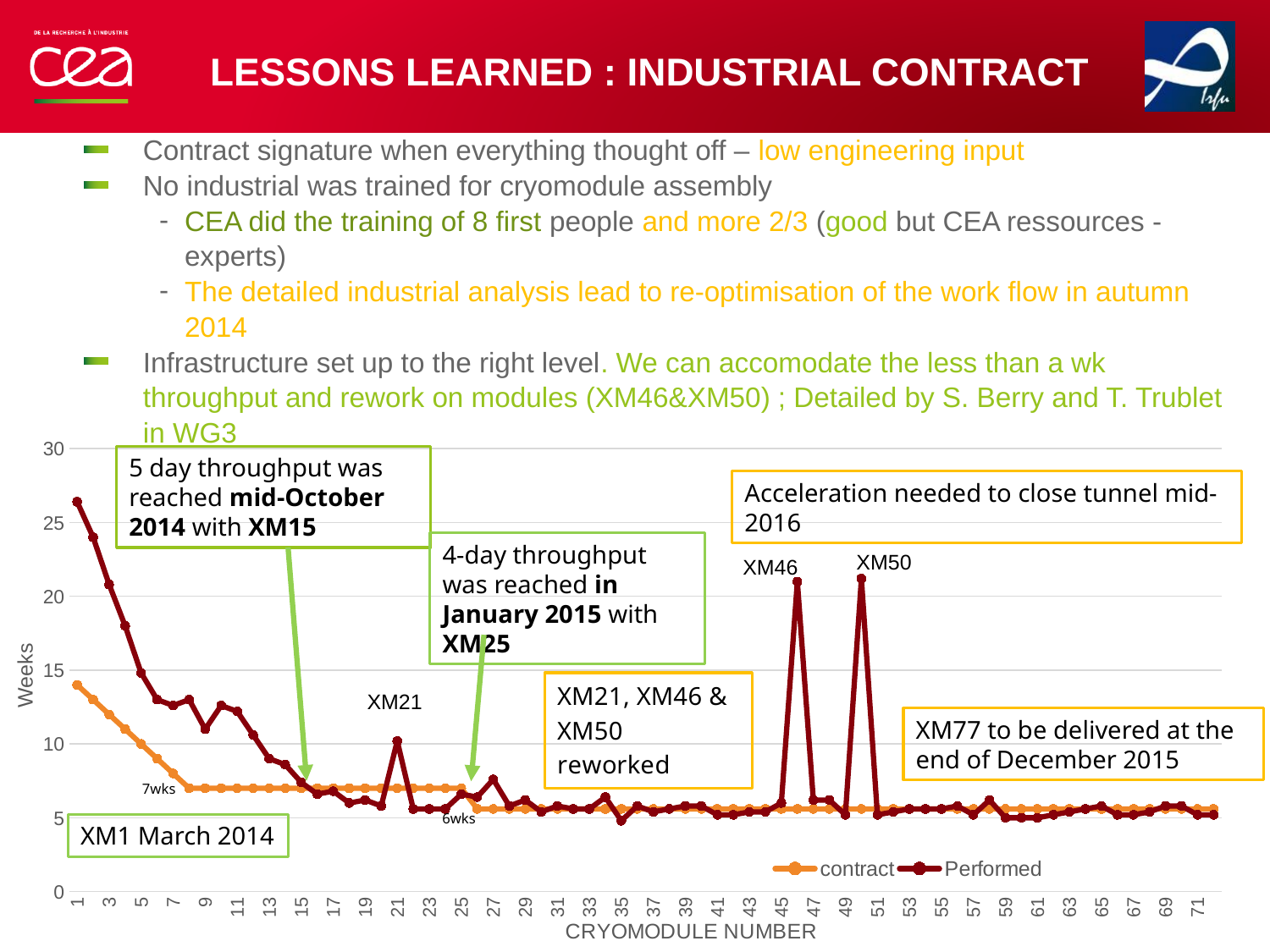
How many series does the chart legend list? 2 Is the contract value at cryomodule number 1 greater or less than 10 weeks? greater What are the two series named in the chart legend? contract and Performed What kind of chart is shown on the slide? line chart Is the Performed value at XM46 greater or less than 20 weeks? greater What value is printed as a data label on the contract line near cryomodule number 25? 6wks What value is printed as a data label on the contract line near cryomodule number 7? 7wks At cryomodule number 1, which series has the larger value, contract or Performed? Performed Overall, does the Performed series rise or fall as the cryomodule number increases? fall Is the Performed value at cryomodule number 1 greater or less than 25 weeks? greater What is the label of the chart's vertical axis? Weeks